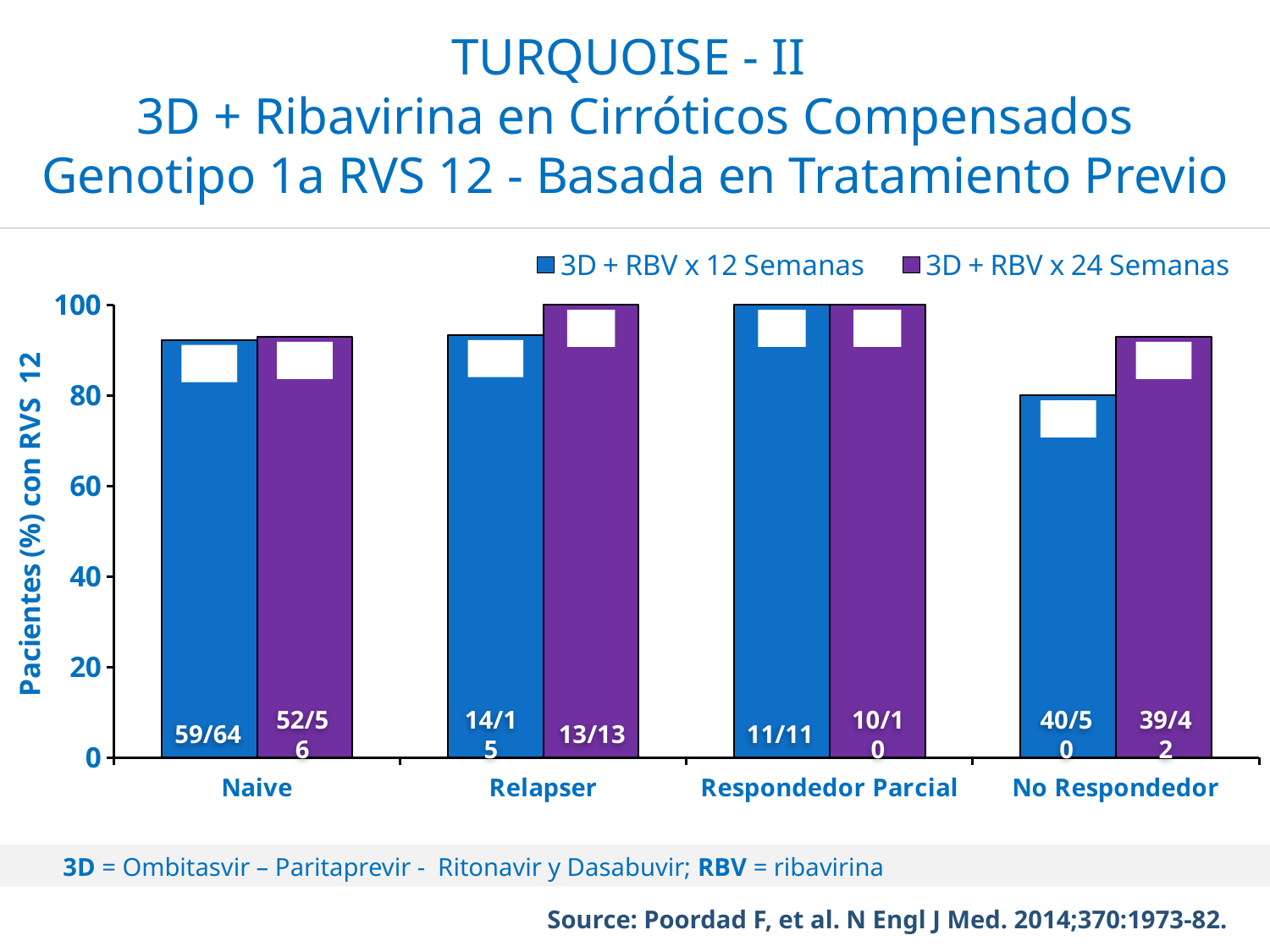
What label is printed on the 3D + RBV x 24 Semanas bar for No Respondedor? 39/42 What are the two series named in the chart legend? 3D + RBV x 12 Semanas and 3D + RBV x 24 Semanas Which category has the lowest value for 3D + RBV x 12 Semanas? No Respondedor What label is printed on the 3D + RBV x 12 Semanas bar for Respondedor Parcial? 11/11 For No Respondedor, which series has the larger value: 3D + RBV x 12 Semanas or 3D + RBV x 24 Semanas? 3D + RBV x 24 Semanas What is the title of the y axis of the chart? Pacientes (%) con RVS 12 Is the value for Naive with 3D + RBV x 12 Semanas greater or less than 80? greater How many series does the chart legend list? 2 What label is printed on the 3D + RBV x 12 Semanas bar for Naive? 59/64 How many categories are shown on the x axis of the chart? 4 For Relapser, which series has the larger value: 3D + RBV x 12 Semanas or 3D + RBV x 24 Semanas? 3D + RBV x 24 Semanas What kind of chart is shown on the slide? bar chart